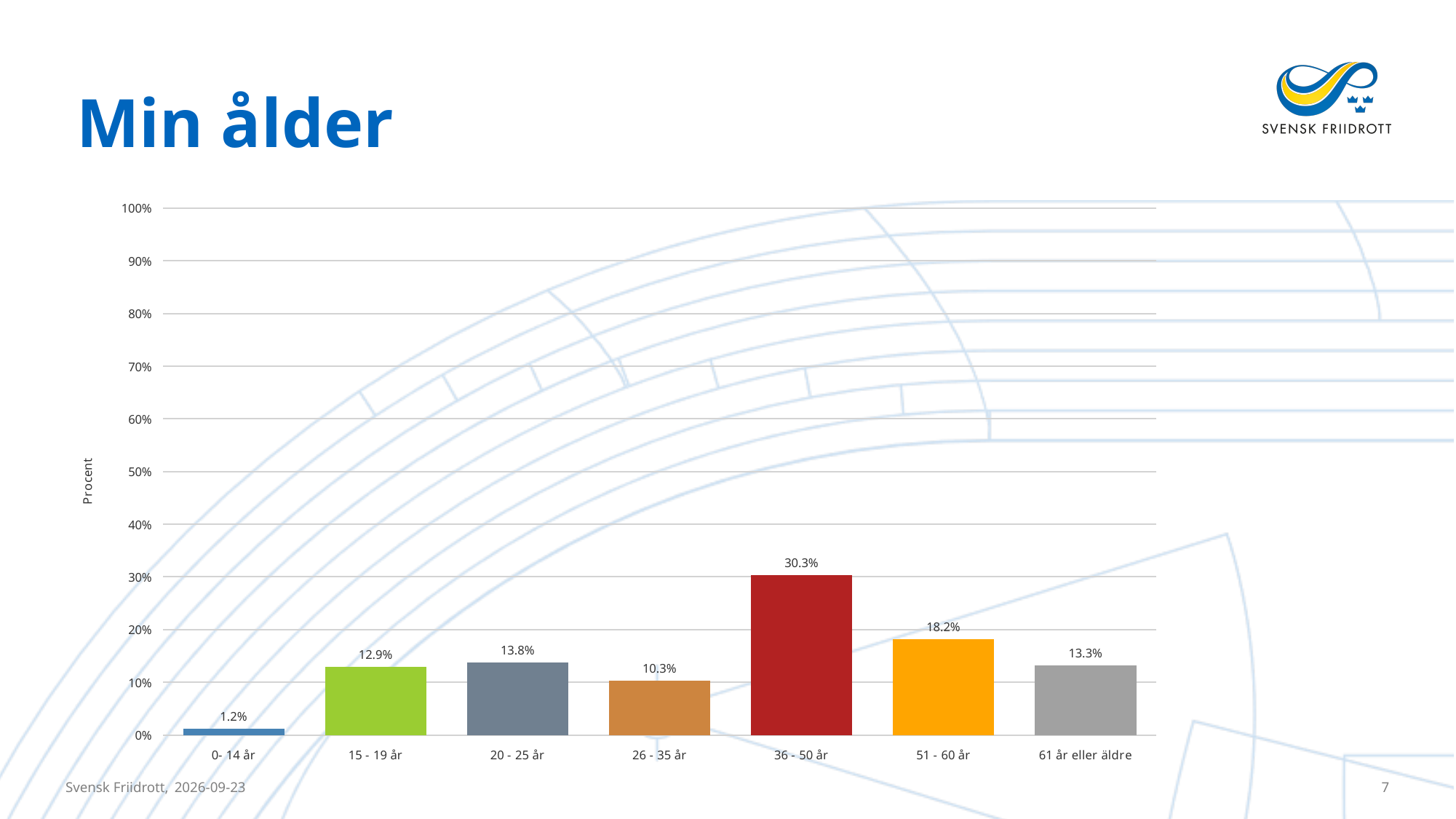
What is the difference between the 36 - 50 år and 51 - 60 år values? 12.1% What percentage is shown for 61 år eller äldre? 13.3% What is the value for the 0- 14 år category? 1.2% What is the label of the vertical axis? Procent Which age group has the highest percentage? 36 - 50 år What kind of chart is shown on the slide? bar chart What is the title of the slide containing the chart? Min ålder Which is larger, the value for 20 - 25 år or the value for 26 - 35 år? 20 - 25 år How many age categories are shown on the x axis? 7 What percentage is shown for the 36 - 50 år age group? 30.3% Which age group has the lowest percentage? 0- 14 år Is the value for 51 - 60 år greater or less than 20%? less